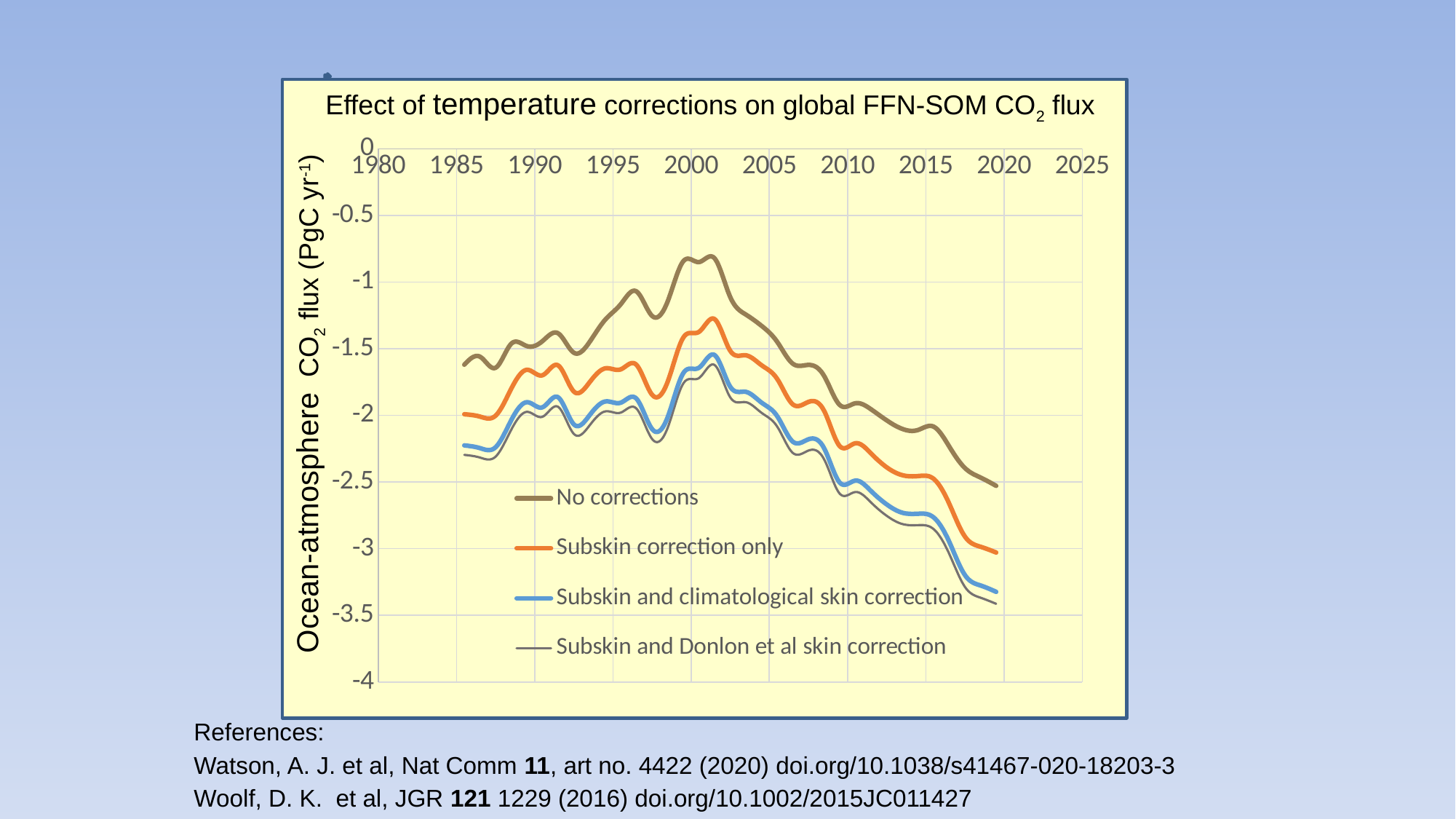
How many series does the legend list? 4 Which series has the lowest values across the whole period? Subskin and Donlon et al skin correction Do the values of the 'No corrections' series rise or fall between 2000 and 2020? fall At 2020, which is larger: the value for 'No corrections' or the value for 'Subskin correction only'? No corrections Which series is drawn in orange? Subskin correction only Is the value of the 'Subskin and climatological skin correction' series at 1985 greater or less than -2.5? greater What kind of chart is shown on the slide? line chart Is the value of the 'No corrections' series around the year 2000 greater or less than -1? greater What is the title of the chart? Effect of temperature corrections on global FFN-SOM CO2 flux Which series has the highest values across the whole period? No corrections Is the value of the 'No corrections' series at 1985 greater or less than -2? greater